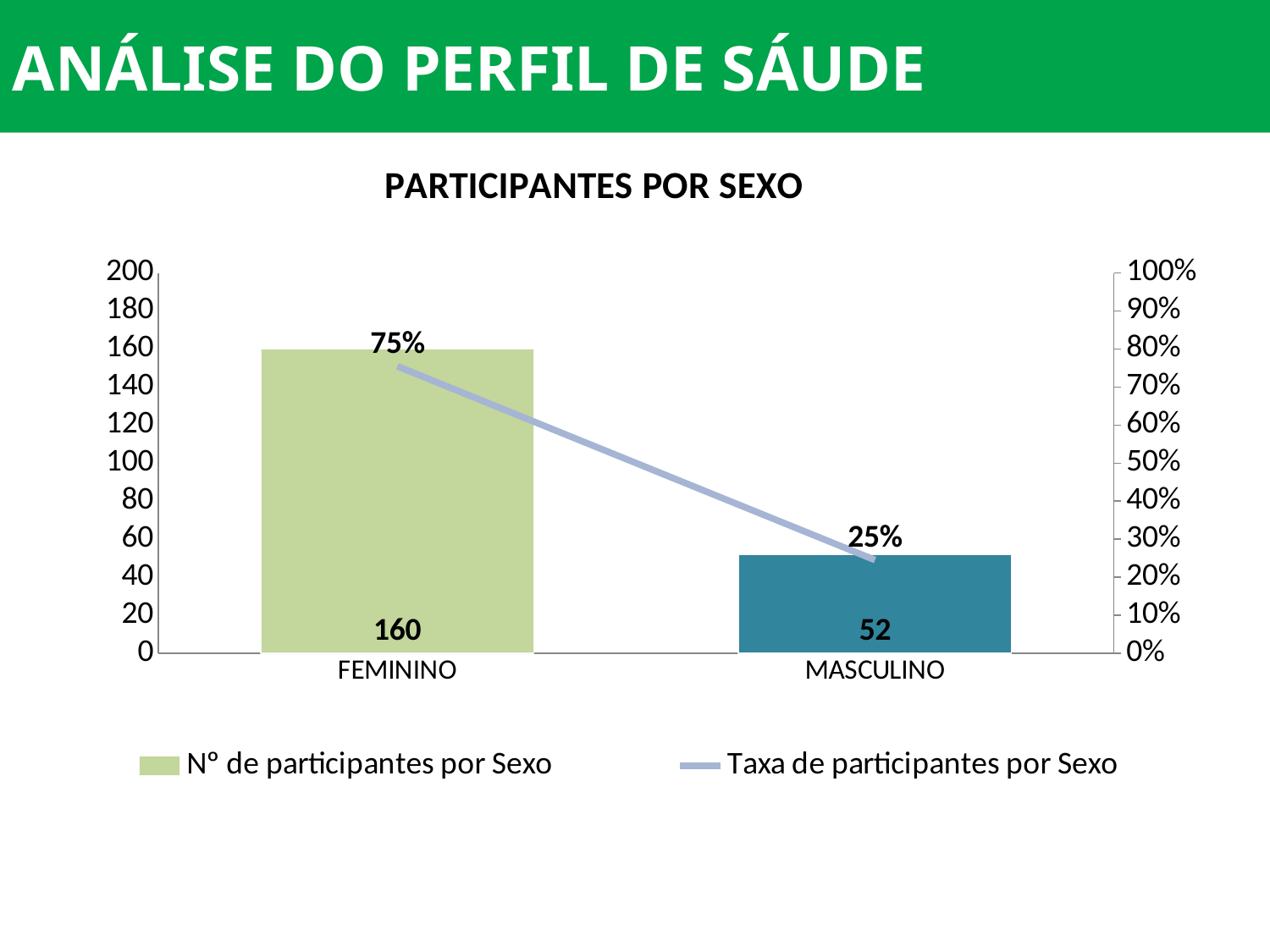
What is the difference in Taxa de participantes por Sexo between FEMININO and MASCULINO? 50% What is the difference in number of participants between FEMININO and MASCULINO? 108 Which category has the lowest number of participants? MASCULINO Is the number of participants for FEMININO greater or less than 140? greater What is the Taxa de participantes por Sexo for MASCULINO? 25% How many categories are shown on the x axis? 2 What is the number of participants for FEMININO? 160 What is the Taxa de participantes por Sexo for FEMININO? 75% Which category has the highest number of participants? FEMININO What is the number of participants for MASCULINO? 52 How many series does the legend list? 2 What is the title of the chart? PARTICIPANTES POR SEXO